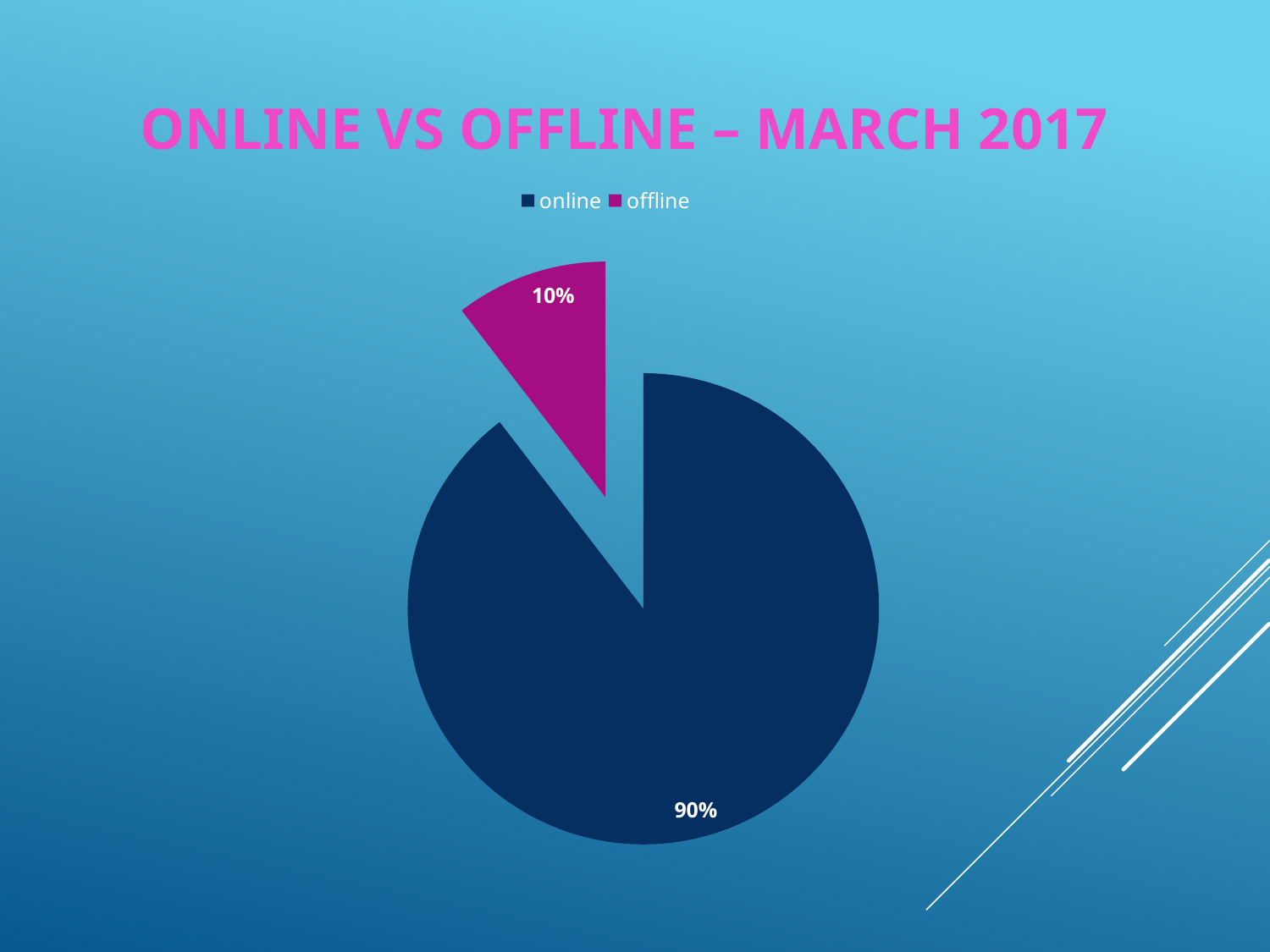
How many entries does the legend list? 2 Which category has the largest slice of the pie? online What is the difference in percentage points between the online and offline slices? 80 percentage points How many slices does the pie chart have? 2 What colour is the offline slice? magenta What kind of chart is shown on the slide? pie chart What share of the pie does the online slice represent? 90% What share of the pie does the offline slice represent? 10% Which category has the smallest slice of the pie? offline Which is larger, the online slice or the offline slice? online What is the title of the slide? ONLINE VS OFFLINE – MARCH 2017